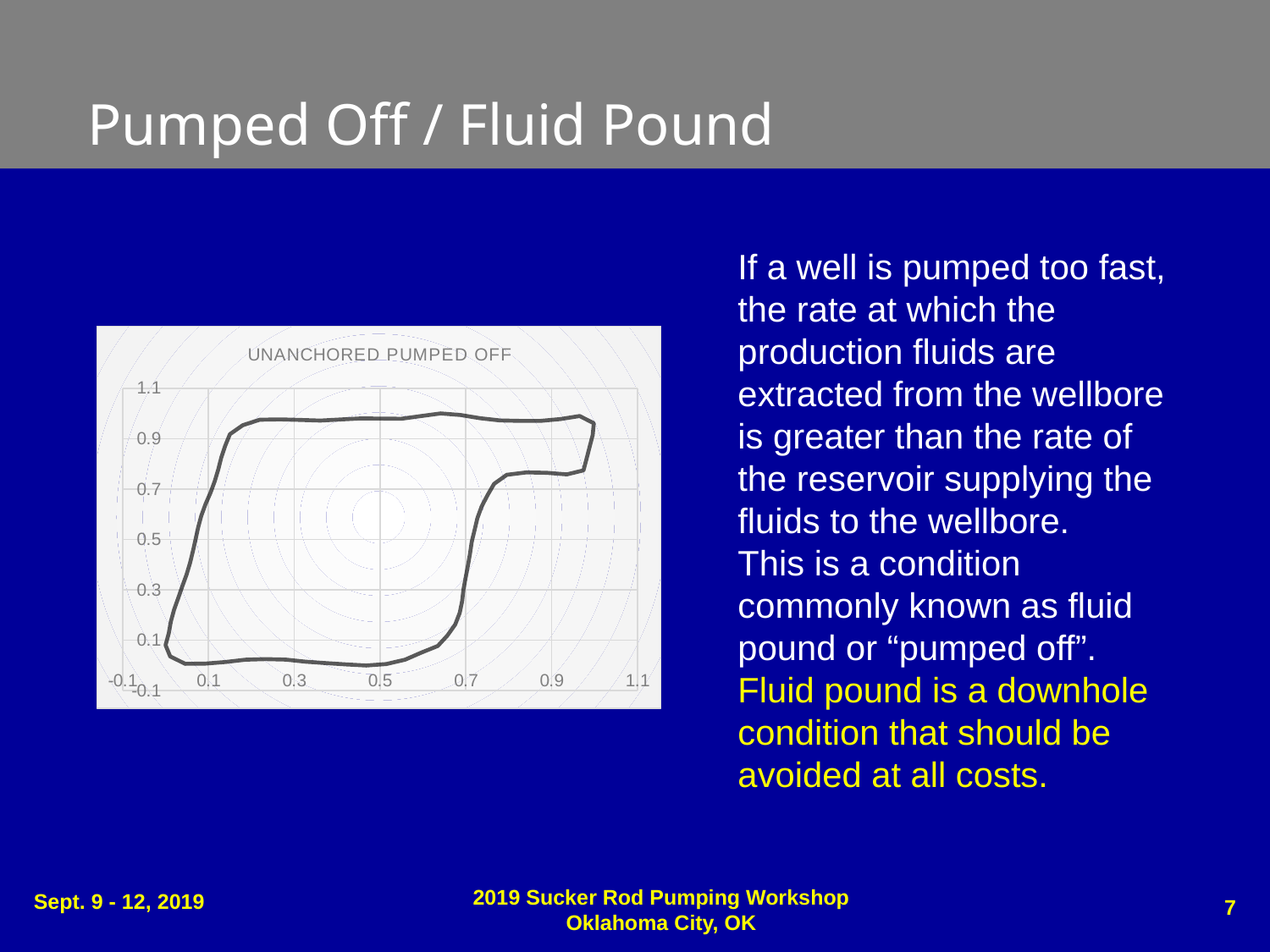
Is the highest point of the plotted loop greater or less than 1.1 on the vertical axis? less How many tick labels are shown on the horizontal axis of the chart? 7 Is the highest point of the plotted loop greater or less than 0.9 on the vertical axis? greater What is the title of the chart on the slide? UNANCHORED PUMPED OFF Is the left-most point of the plotted loop greater or less than 0.1 on the horizontal axis? less What is the largest tick value shown on the vertical axis of the chart? 1.1 What kind of chart is shown on the slide? Line chart (closed loop plotted on x-y axes)